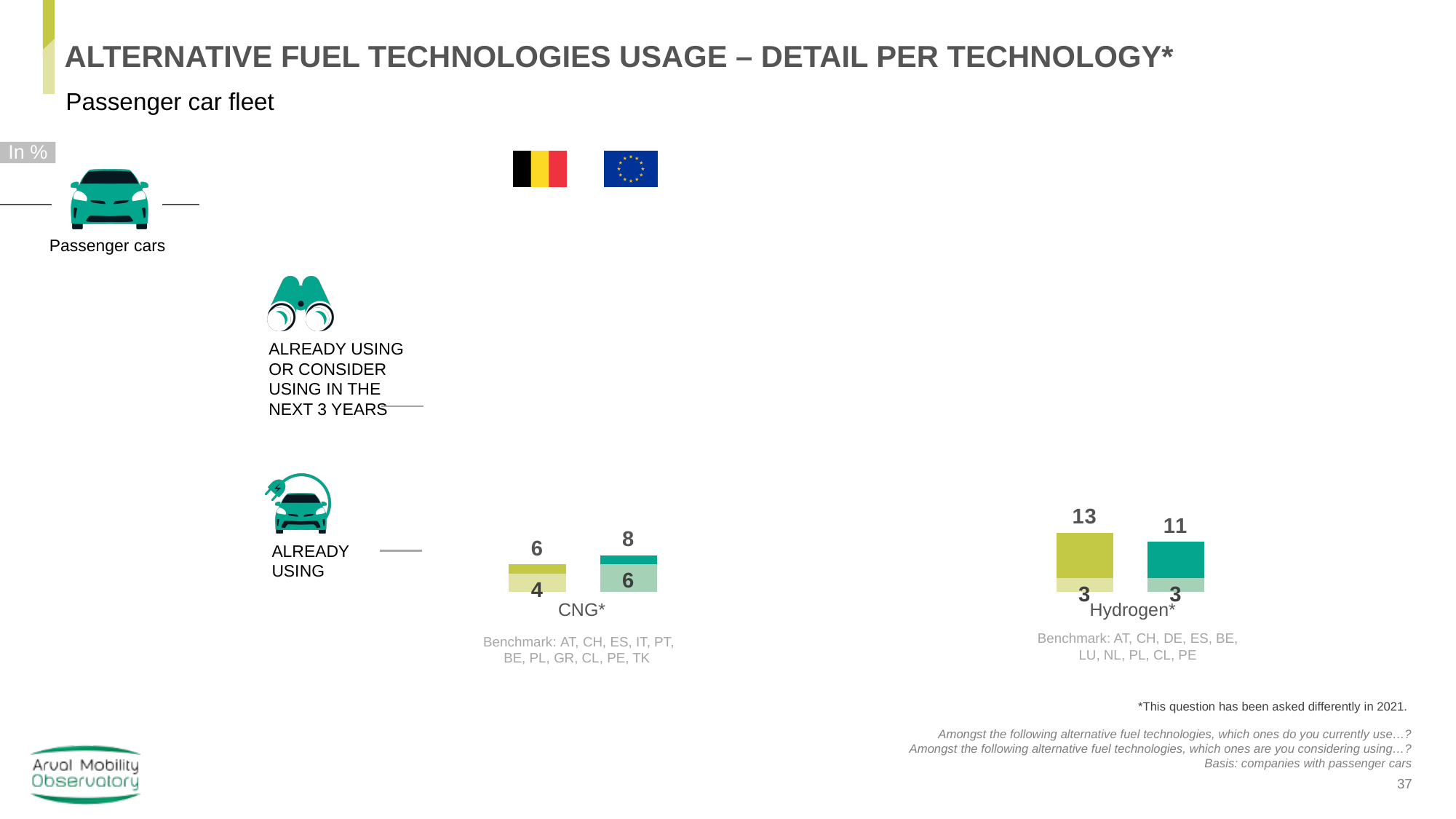
In the CNG* chart, what is the value for Belgium for 'already using or consider using in the next 3 years'? 6 In the Hydrogen* chart, which has the higher 'already using or consider using in the next 3 years' value, Belgium or the EU? Belgium In the CNG* chart, what is the 'already using' value for Belgium? 4 In the CNG* chart, what is the 'already using' value for the EU? 6 In what unit are the values on the slide expressed? % In the Hydrogen* chart, what is the value for the EU for 'already using or consider using in the next 3 years'? 11 What kind of chart is used to show the CNG* and Hydrogen* data? Bar chart In the CNG* chart, which has the higher 'already using or consider using in the next 3 years' value, Belgium or the EU? EU In the Hydrogen* chart, what is the value for Belgium for 'already using or consider using in the next 3 years'? 13 In the Hydrogen* chart, what is the 'already using' value for Belgium? 3 In the CNG* chart, what is the value for the EU for 'already using or consider using in the next 3 years'? 8 In the Hydrogen* chart, what is the difference between Belgium and the EU for 'already using or consider using in the next 3 years'? 2